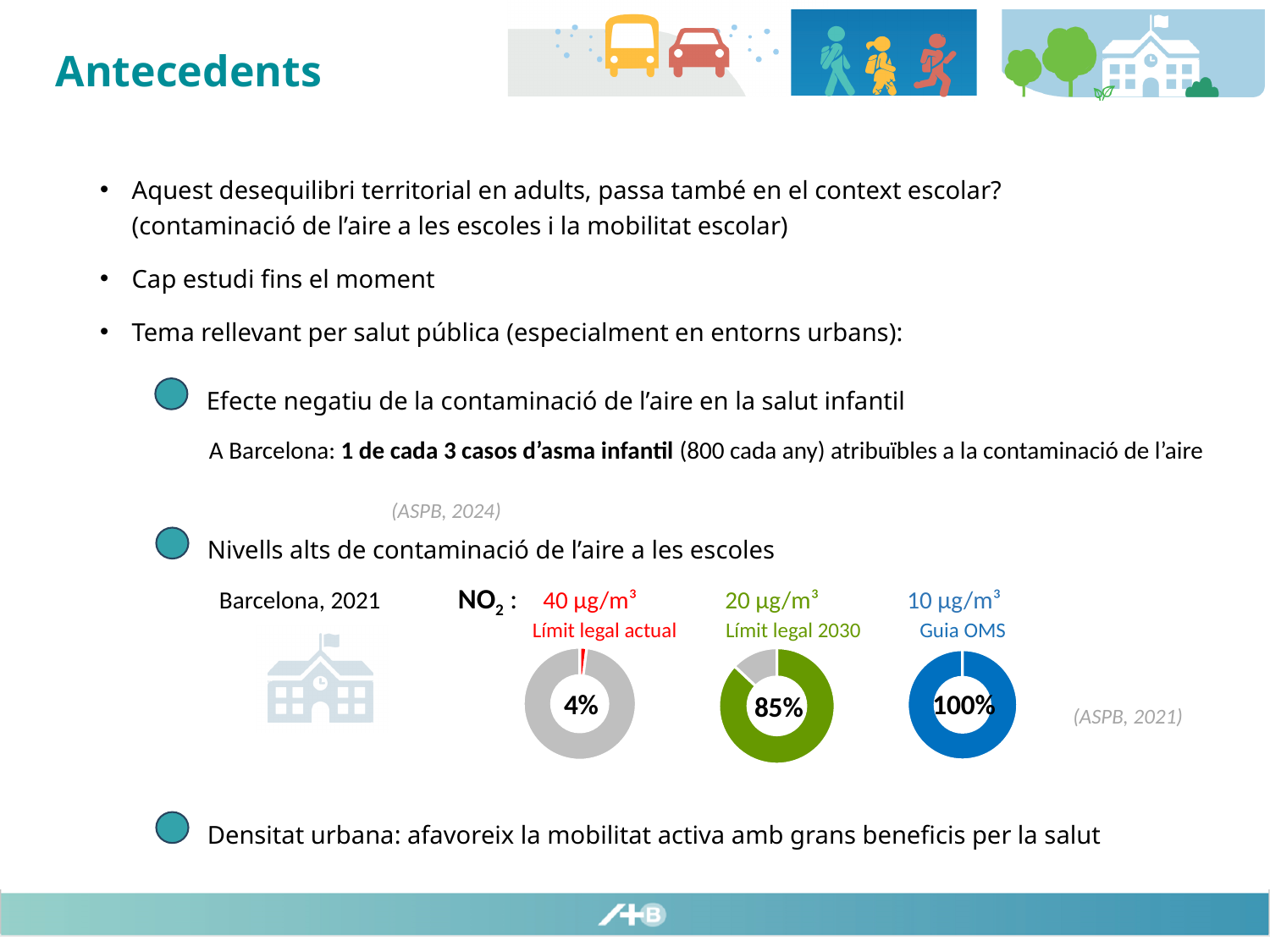
Which of the three donut charts shows the highest percentage? Guia OMS Which is larger: the percentage in the 'Límit legal 2030' chart or the percentage in the 'Límit legal actual' chart? Límit legal 2030 What percentage is shown in the donut chart labelled 'Guia OMS'? 100% What percentage is shown in the donut chart labelled 'Límit legal 2030'? 85% What kind of chart is used to show the percentages for the NO2 limits? Donut (pie) chart Which of the three donut charts shows the lowest percentage? Límit legal actual What is the difference between the percentage in the 'Límit legal 2030' chart and the percentage in the 'Límit legal actual' chart? 81% What colour is the filled portion of the 'Guia OMS' donut chart? Blue What NO2 threshold value is associated with the 'Límit legal 2030' donut chart? 20 µg/m³ What percentage is shown in the donut chart labelled 'Límit legal actual'? 4% What is the difference between the percentage in the 'Guia OMS' chart and the percentage in the 'Límit legal 2030' chart? 15% How many donut charts are shown on the slide? 3